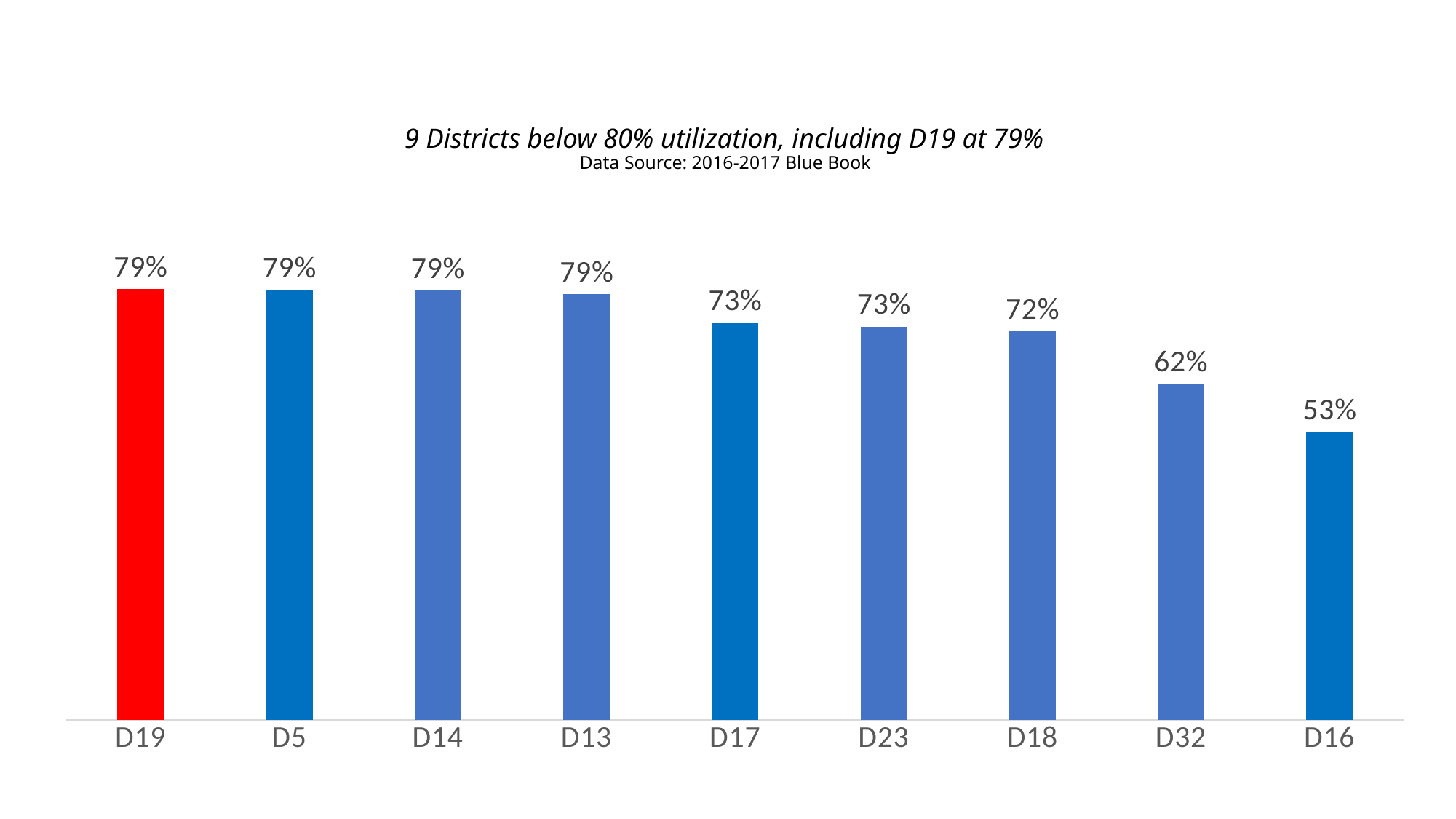
What is the utilization value shown for D19? 79% What kind of chart is shown on the slide? Bar chart What is the difference between the utilization of D19 and D16? 26% Which district's bar is coloured red? D19 How many districts are shown on the chart? 9 Which district has the lowest utilization on the chart? D16 What is the utilization value shown for D18? 72% What is the utilization value shown for D17? 73% Do the values rise or fall moving from left to right along the x axis? Fall What is the difference between the utilization of D18 and D32? 10% What is the utilization value shown for D32? 62% Which has a higher utilization, D23 or D32? D23